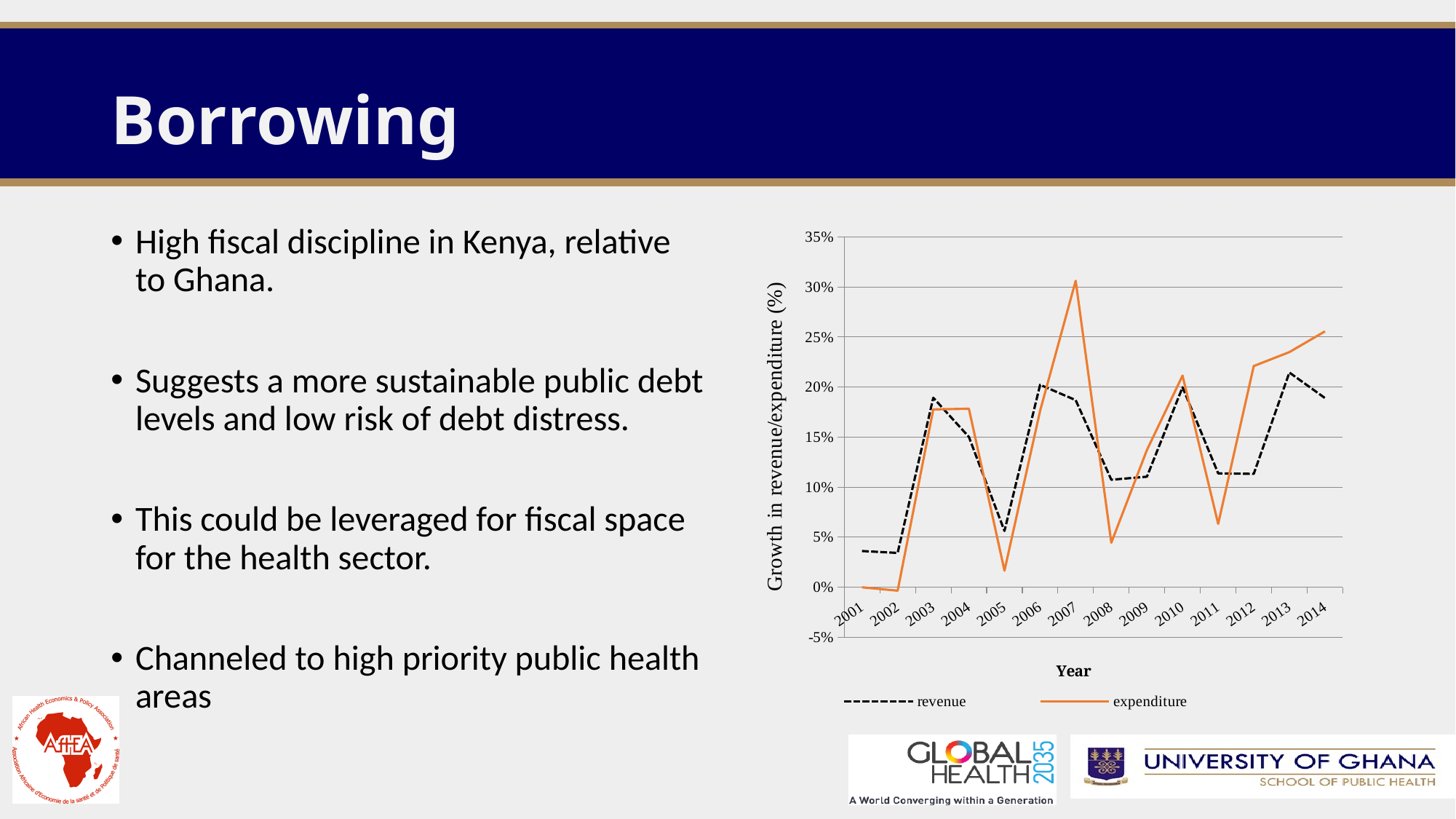
Is the revenue growth value for 2001 greater or less than 5%? less What kind of chart is shown on the slide? line chart Is the revenue growth value for 2005 greater or less than 10%? less What is the label on the chart's y axis? Growth in revenue/expenditure (%) Does expenditure growth rise or fall from 2011 to 2014? rise In 2011, which is larger: revenue growth or expenditure growth? revenue Is the expenditure growth value for 2007 greater or less than 25%? greater In 2007, which is larger: revenue growth or expenditure growth? expenditure How many series does the chart's legend list? 2 In which year is expenditure growth highest? 2007 How many years are plotted along the x axis of the chart? 14